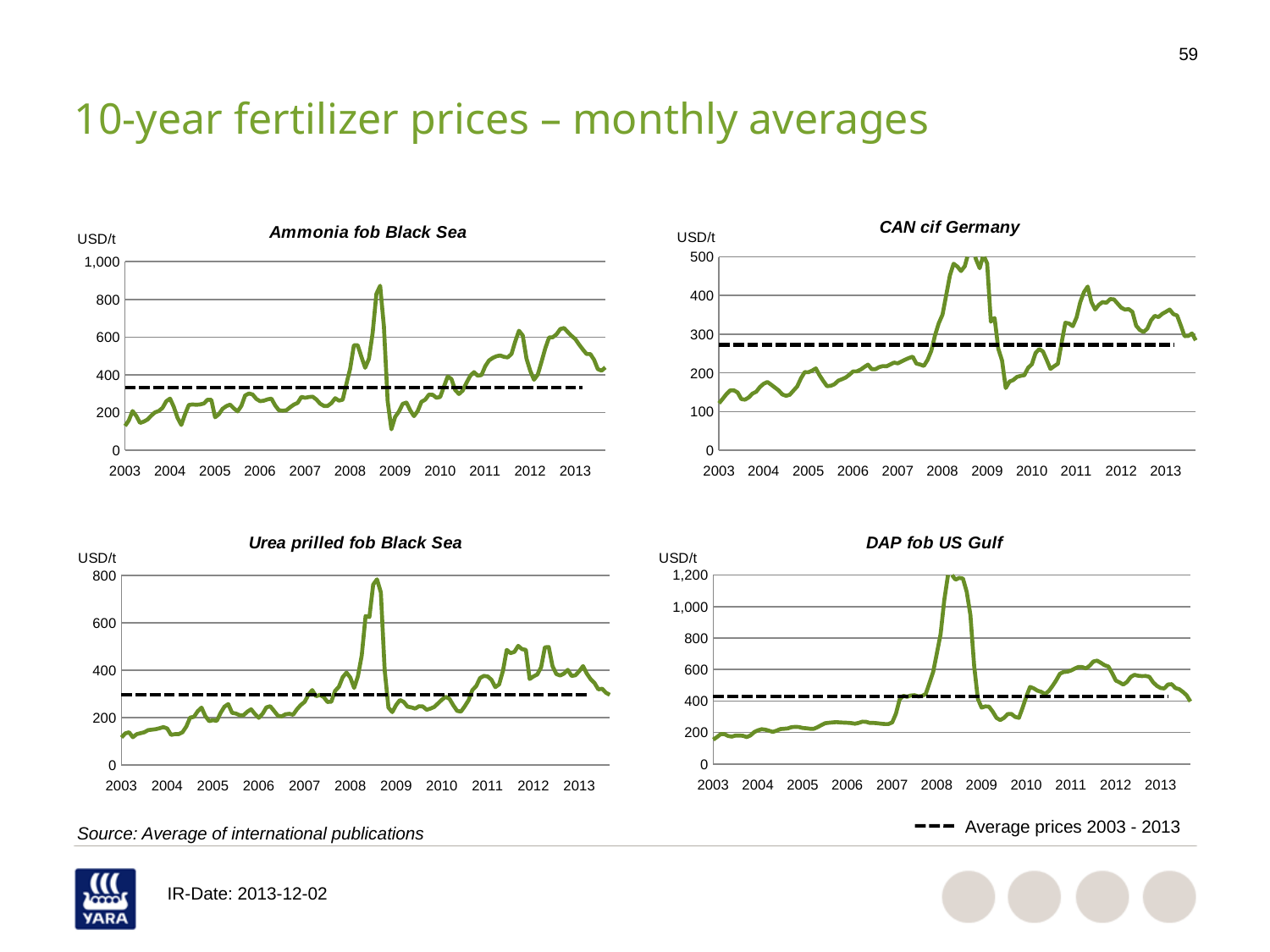
In the Ammonia fob Black Sea chart, which is larger: the peak in 2008 or the peak in 2012? the peak in 2008 What does the dashed line in each chart represent, according to the legend? Average prices 2003 - 2013 In the Ammonia fob Black Sea chart, is the peak value in 2008 greater or less than 800? greater What kind of chart is the Ammonia fob Black Sea chart? line chart In the DAP fob US Gulf chart, is the peak value in 2008 greater or less than 1,000? greater In the CAN cif Germany chart, is the peak value in 2008 greater or less than 400? greater How many charts are shown on the slide? 4 In the CAN cif Germany chart, does the price rise or fall from 2003 to 2008? rise In the DAP fob US Gulf chart, in which year does the price reach its highest value? 2008